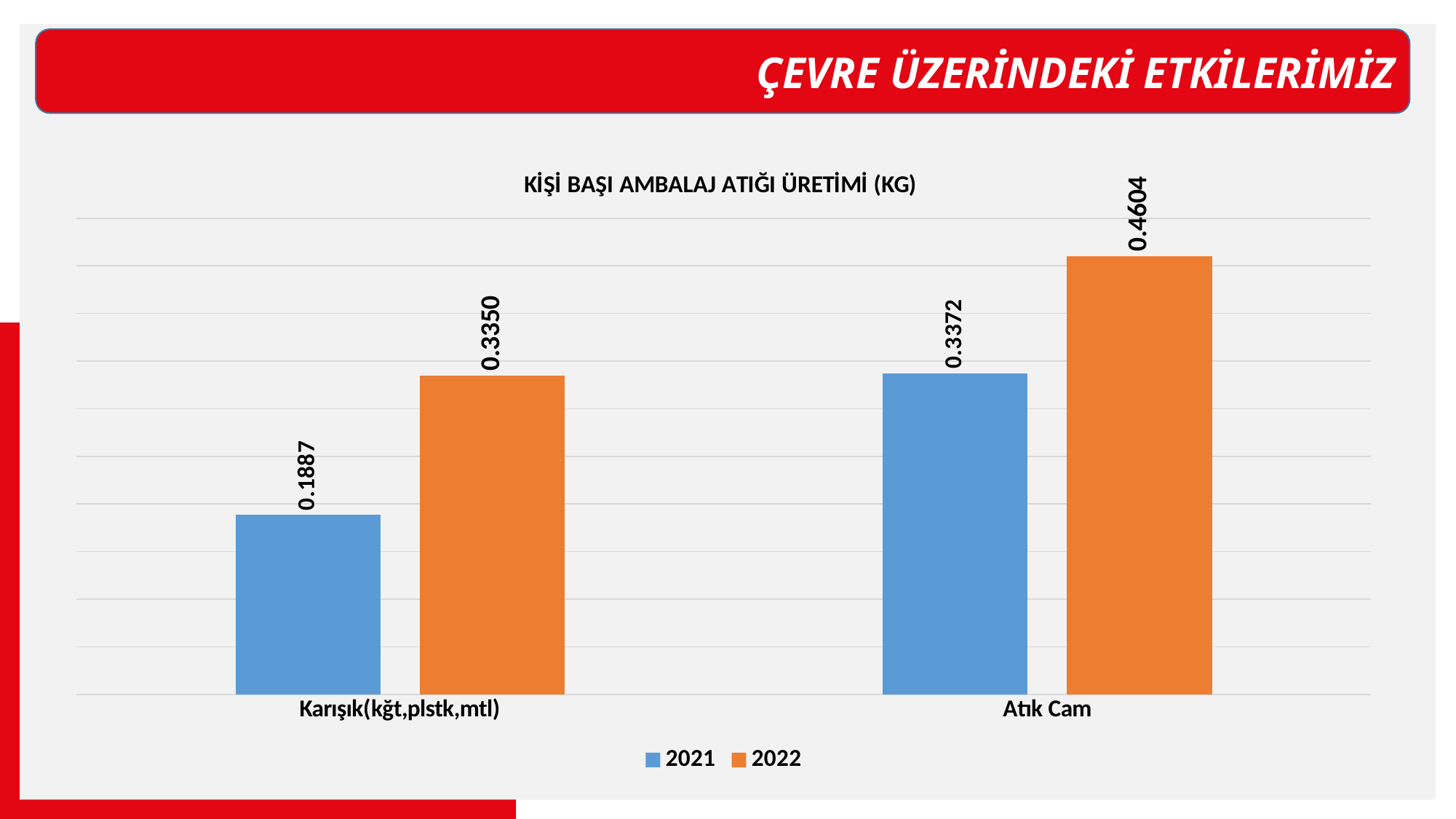
How many categories are shown on the x axis? 2 What is the 2022 value for Atık Cam? 0.4604 Which is larger: the 2021 value for Atık Cam or the 2022 value for Karışık(kğt,plstk,mtl)? 2021 value for Atık Cam What is the 2021 value for Atık Cam? 0.3372 Which category has the lowest 2021 value? Karışık(kğt,plstk,mtl) What is the 2022 value for Karışık(kğt,plstk,mtl)? 0.3350 Which category has the highest 2022 value? Atık Cam What is the 2021 value for Karışık(kğt,plstk,mtl)? 0.1887 What is the difference between the 2022 and 2021 values for Karışık(kğt,plstk,mtl)? 0.1463 What is the difference between the 2022 and 2021 values for Atık Cam? 0.1232 What type of chart is shown on the slide? Bar chart How many series does the legend list? 2